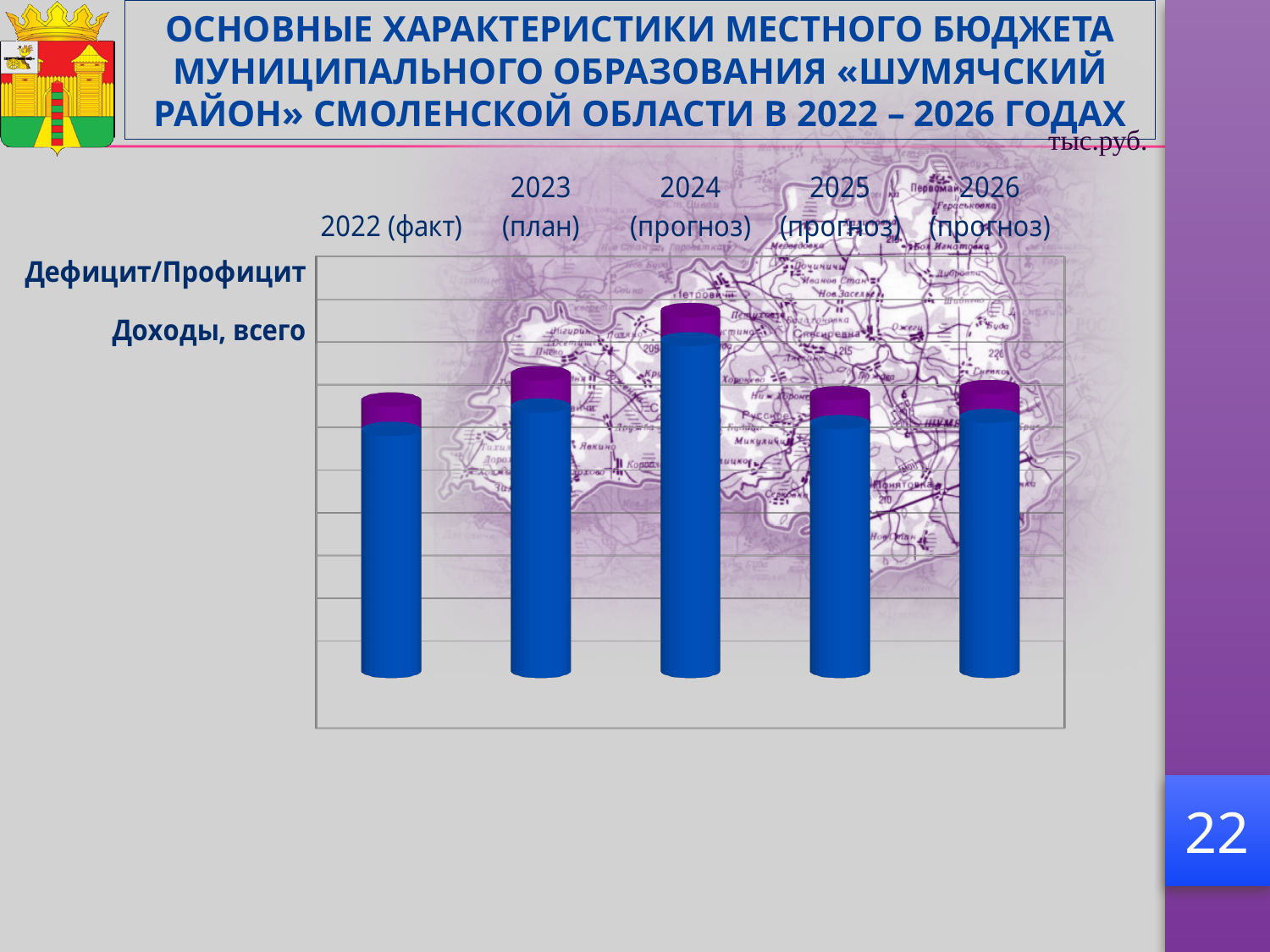
How many year categories are plotted on the chart? 5 Which is larger, the bar for 2024 (прогноз) or the bar for 2022 (факт)? 2024 (прогноз) Which year has the highest bar on the chart? 2024 (прогноз) Do the bars rise or fall from 2024 (прогноз) to 2025 (прогноз)? fall What kind of chart is shown on the slide? bar chart What unit of measurement is indicated for the chart? тыс.руб. Which is larger, the bar for 2024 (прогноз) or the bar for 2026 (прогноз)? 2024 (прогноз) Do the bars rise or fall from 2022 (факт) to 2024 (прогноз)? rise